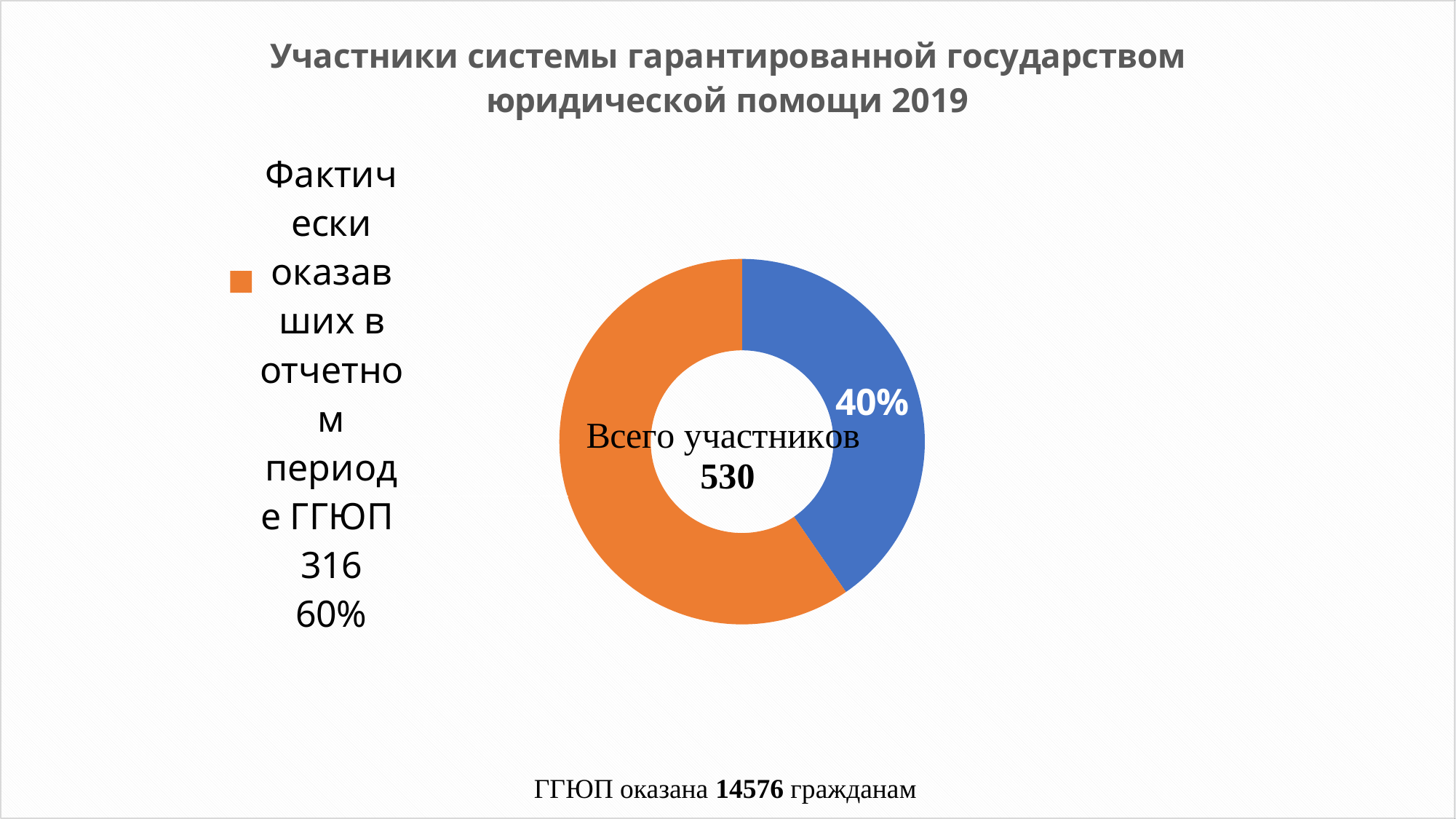
What is the title of the chart? Участники системы гарантированной государством юридической помощи 2019 What kind of chart is shown on the slide? Doughnut (pie) chart How many entries does the legend list? 1 What colour is the slice labelled 40%? Blue How many slices does the doughnut chart have? 2 Is the share of the orange slice greater or less than 50%? greater What is the total number of participants shown in the centre of the chart (Всего участников)? 530 How many participants actually provided ГГЮП in the reporting period, according to the legend? 316 Which slice is larger, the orange one or the blue one? Orange What percentage is shown on the blue slice of the chart? 40% What share of the chart does the orange slice (Фактически оказавших в отчетном периоде ГГЮП) represent? 60% What is the difference in percentage points between the orange slice (60%) and the blue slice (40%)? 20%